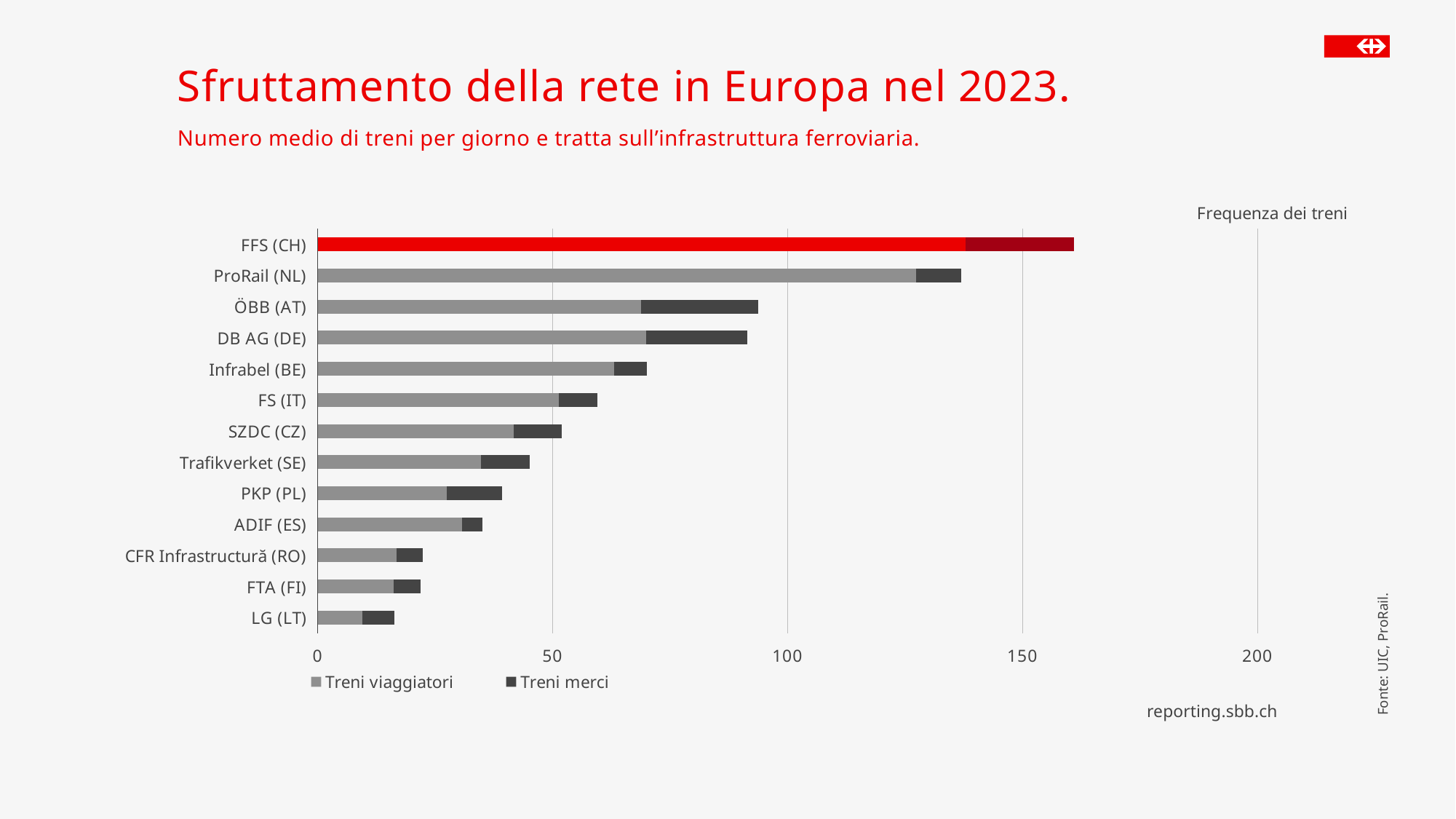
Is the total value for Trafikverket (SE) greater or less than 50? less Which operator has the highest total train frequency? FFS (CH) Which has a larger total train frequency, Infrabel (BE) or FS (IT)? Infrabel (BE) Is the total value for ProRail (NL) greater or less than 150? less Is the total value for Infrabel (BE) greater or less than 50? greater Which operator has the lowest total train frequency? LG (LT) How many series does the legend list? 2 What kind of chart is shown on the slide? bar chart What are the two series named in the legend? Treni viaggiatori and Treni merci How many railway infrastructure operators are listed on the chart? 13